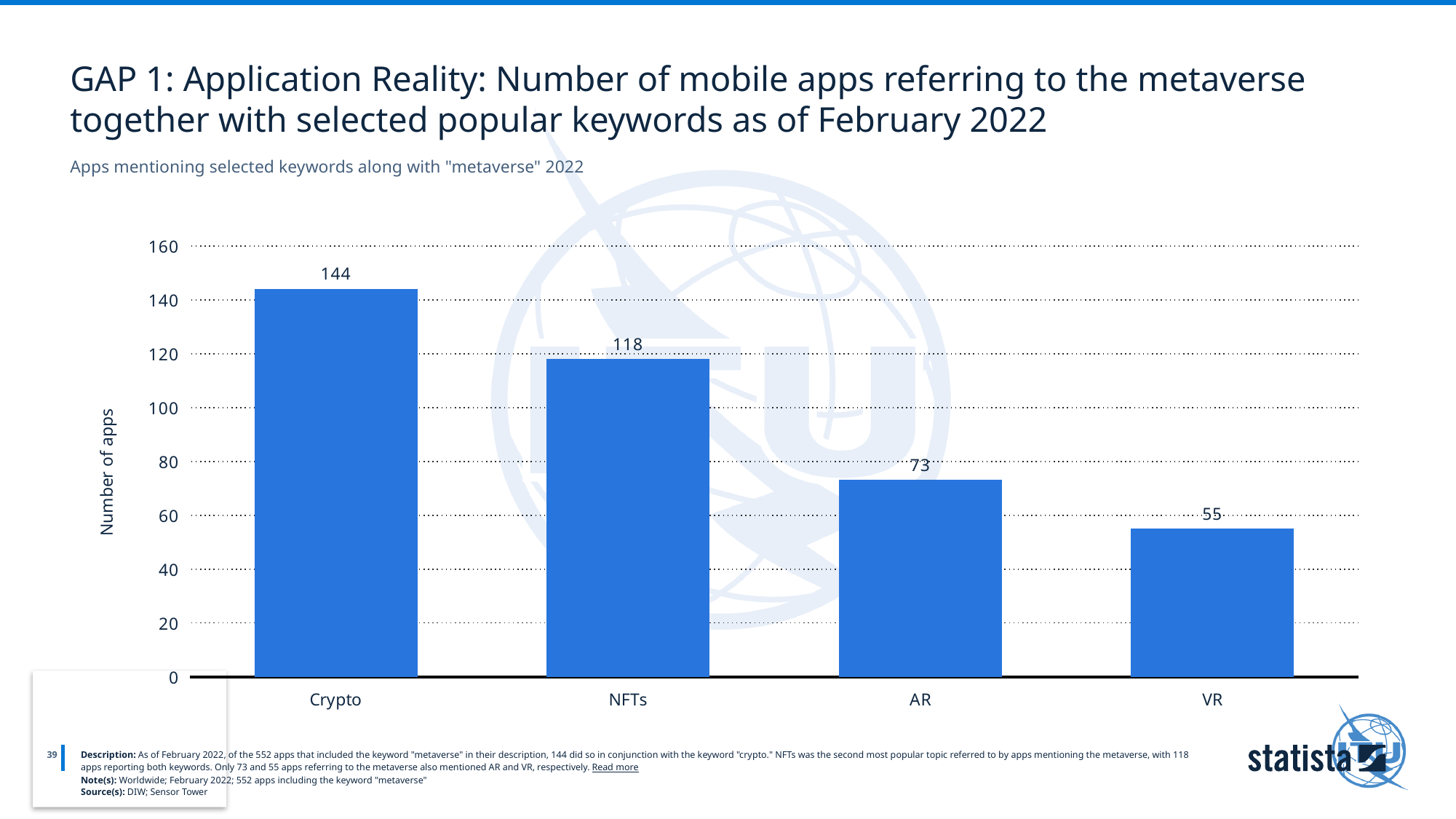
What is the difference in number of apps between AR and VR? 18 How many keyword categories are shown in the chart? 4 How many apps mention Crypto along with "metaverse"? 144 Which keyword has the lowest number of apps? VR Which has more apps, NFTs or AR? NFTs What is the number of apps for VR? 55 What type of chart is shown on the slide? Bar chart Do the values rise or fall from left to right across the categories? Fall What is the number of apps for NFTs? 118 Which keyword has the highest number of apps? Crypto What is the number of apps for AR? 73 What is the difference in number of apps between Crypto and NFTs? 26